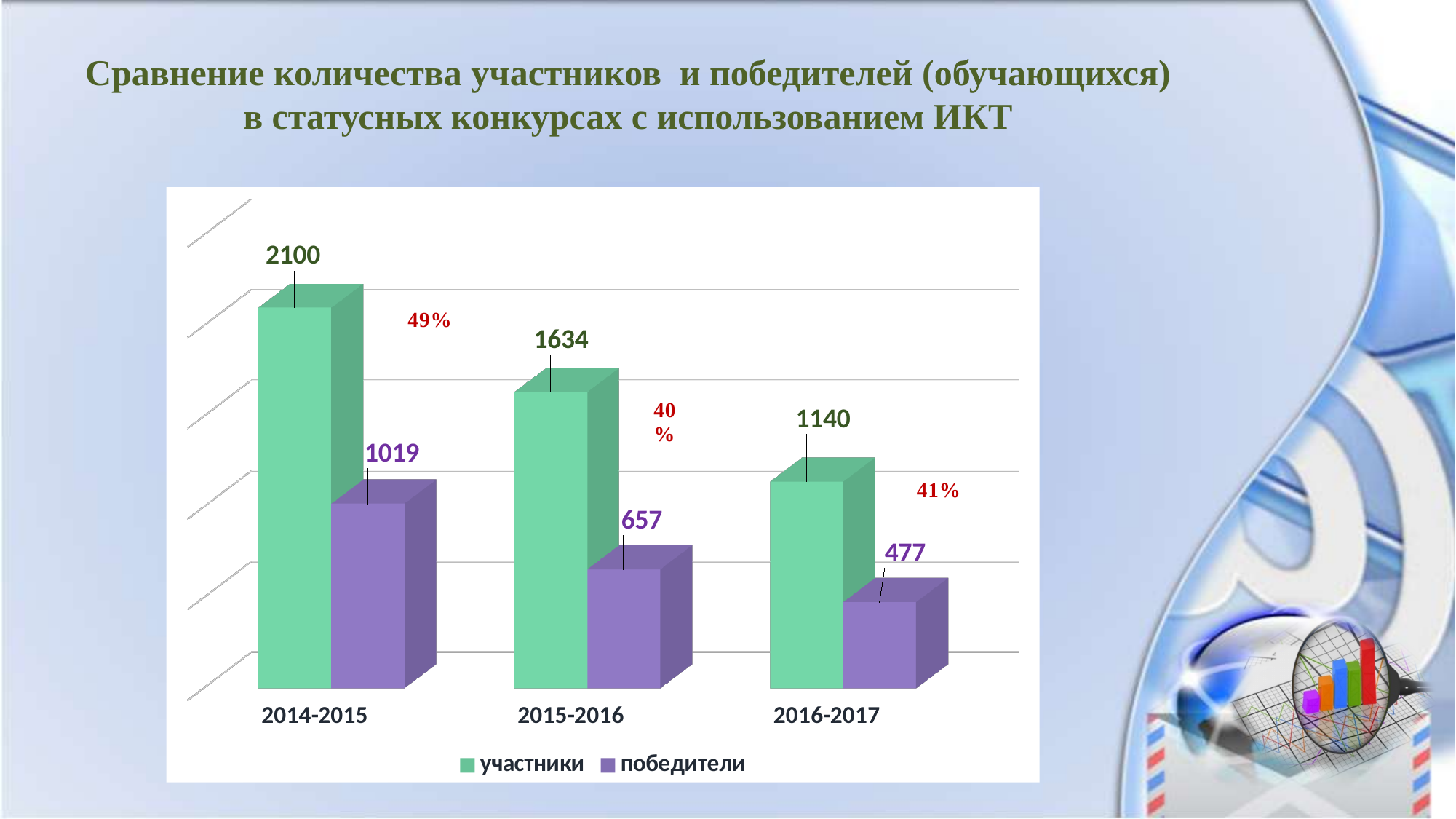
Which year has the highest value for участники? 2014-2015 What is the value for участники in 2014-2015? 2100 Which is larger: победители in 2014-2015 or участники in 2016-2017? участники in 2016-2017 What is the value for победители in 2015-2016? 657 What kind of chart is shown on the slide? bar chart What is the value for победители in 2014-2015? 1019 How many series does the legend list? 2 How many year categories are shown on the x axis? 3 What is the difference between участники and победители in 2015-2016? 977 What is the difference between участники in 2014-2015 and участники in 2016-2017? 960 Which year has the lowest value for победители? 2016-2017 What is the value for участники in 2016-2017? 1140